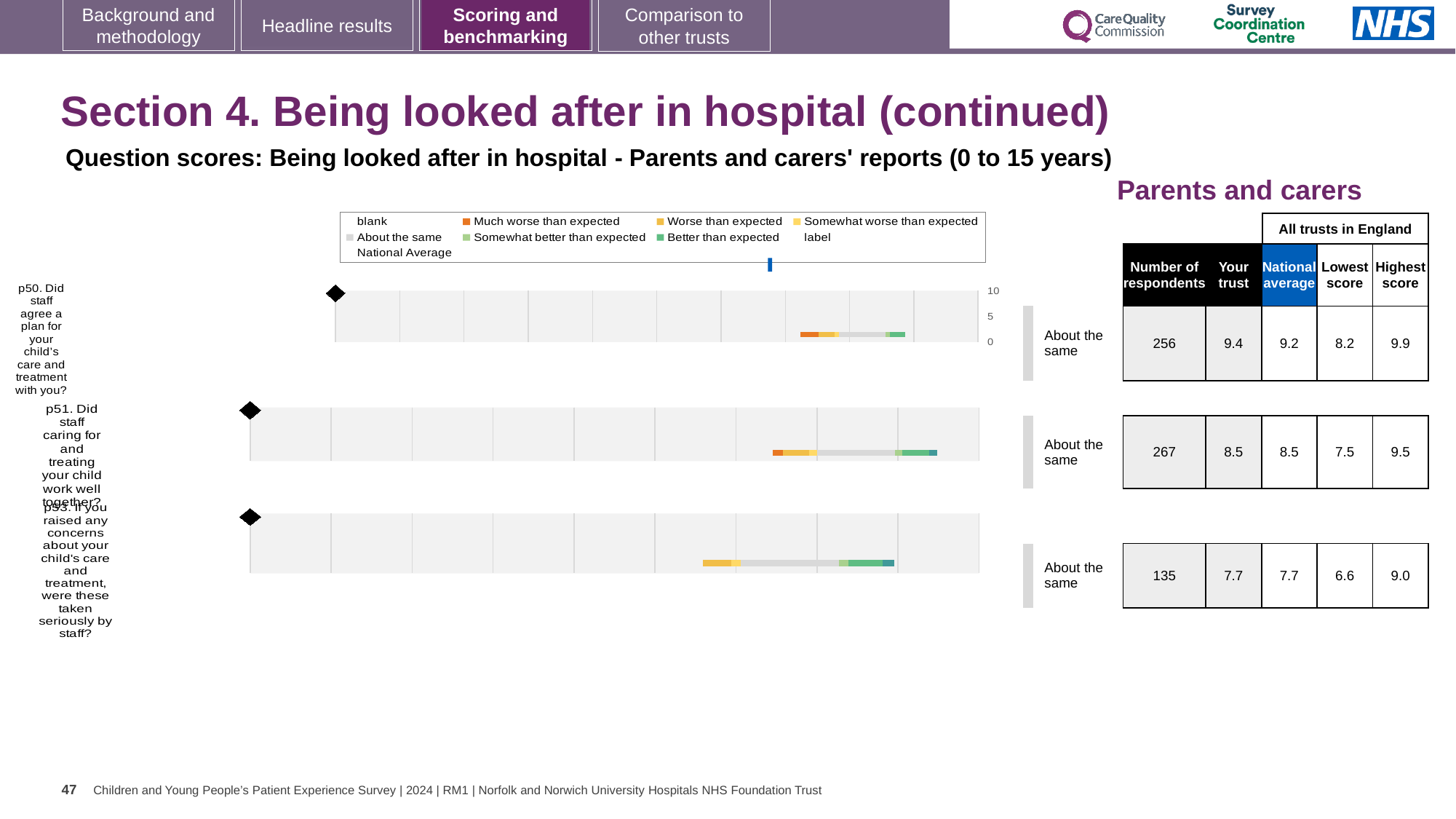
What is the lowest score across all trusts in England for p53? 6.6 How many questions are charted on this slide? 3 What is the national average score for p51 (Did staff caring for and treating your child work well together?)? 8.5 Which question has the lowest number of respondents on this slide? p53 Which question has the highest 'Your trust' score on this slide? p50 How many respondents are listed for p53 (If you raised any concerns about your child's care and treatment, were these taken seriously by staff?)? 135 What kind of chart is used to show the question scores on this slide? Bar chart What benchmark category is shown for p51? About the same What is the 'Your trust' score for p50 (Did staff agree a plan for your child's care and treatment with you?)? 9.4 For p51, what is the difference between the highest score and the lowest score across all trusts in England? 2.0 What is the highest score across all trusts in England for p50? 9.9 For p50, which is larger: the 'Your trust' score or the national average? Your trust